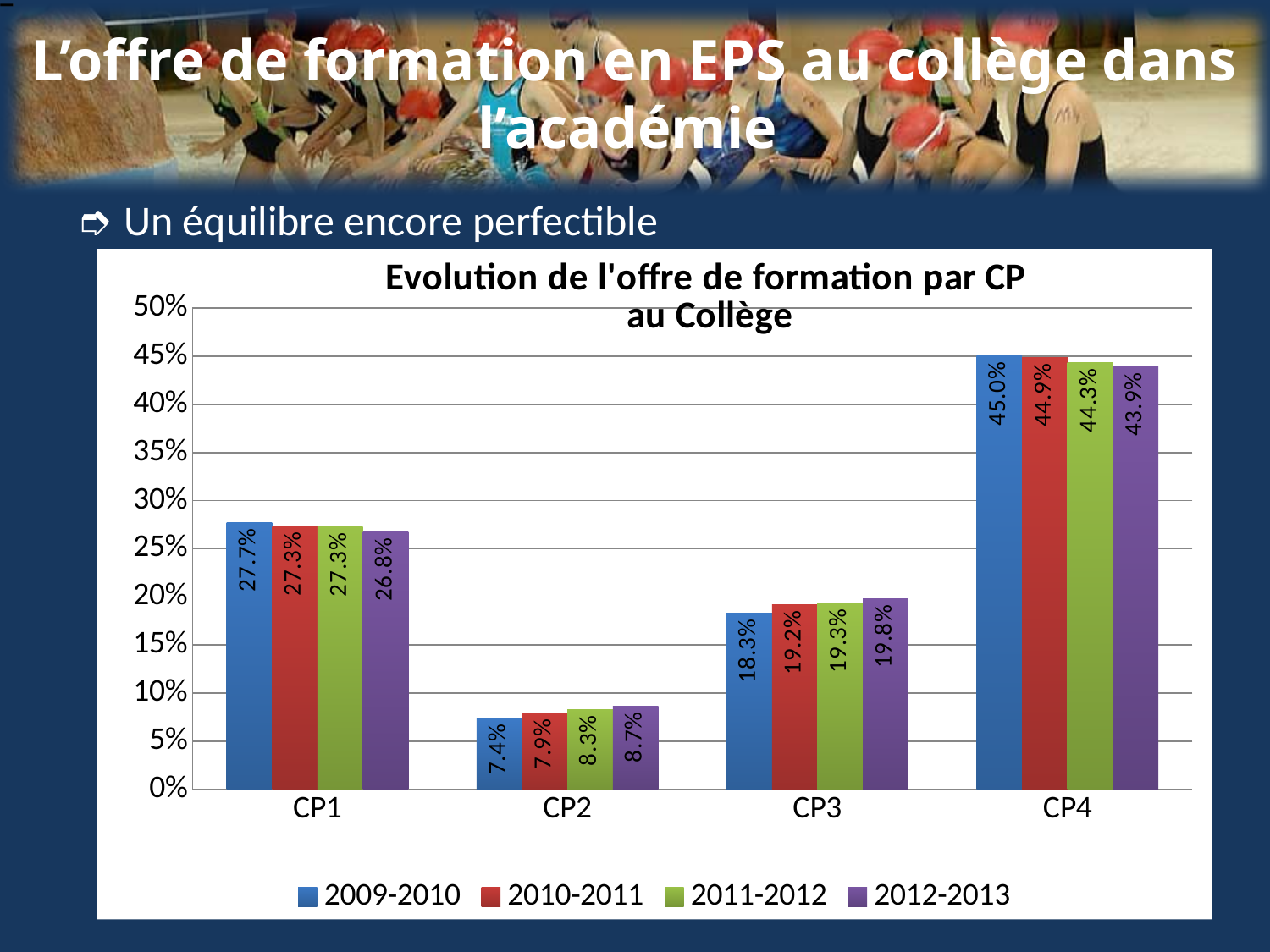
What is the value for CP4 in the 2011-2012 series? 44.3% What is the difference between the 2009-2010 and 2012-2013 values for CP4? 1.1% How many categories are shown on the x axis? 4 Which category has the highest value in the 2009-2010 series? CP4 What is the value for CP2 in the 2012-2013 series? 8.7% Which is larger for CP3: the 2009-2010 value or the 2012-2013 value? 2012-2013 How many series does the legend list? 4 What is the value for CP3 in the 2010-2011 series? 19.2% Which category has the lowest value in the 2012-2013 series? CP2 What is the value for CP1 in the 2009-2010 series? 27.7% What is the title of the chart? Evolution de l'offre de formation par CP au Collège What kind of chart is shown on the slide? Bar chart